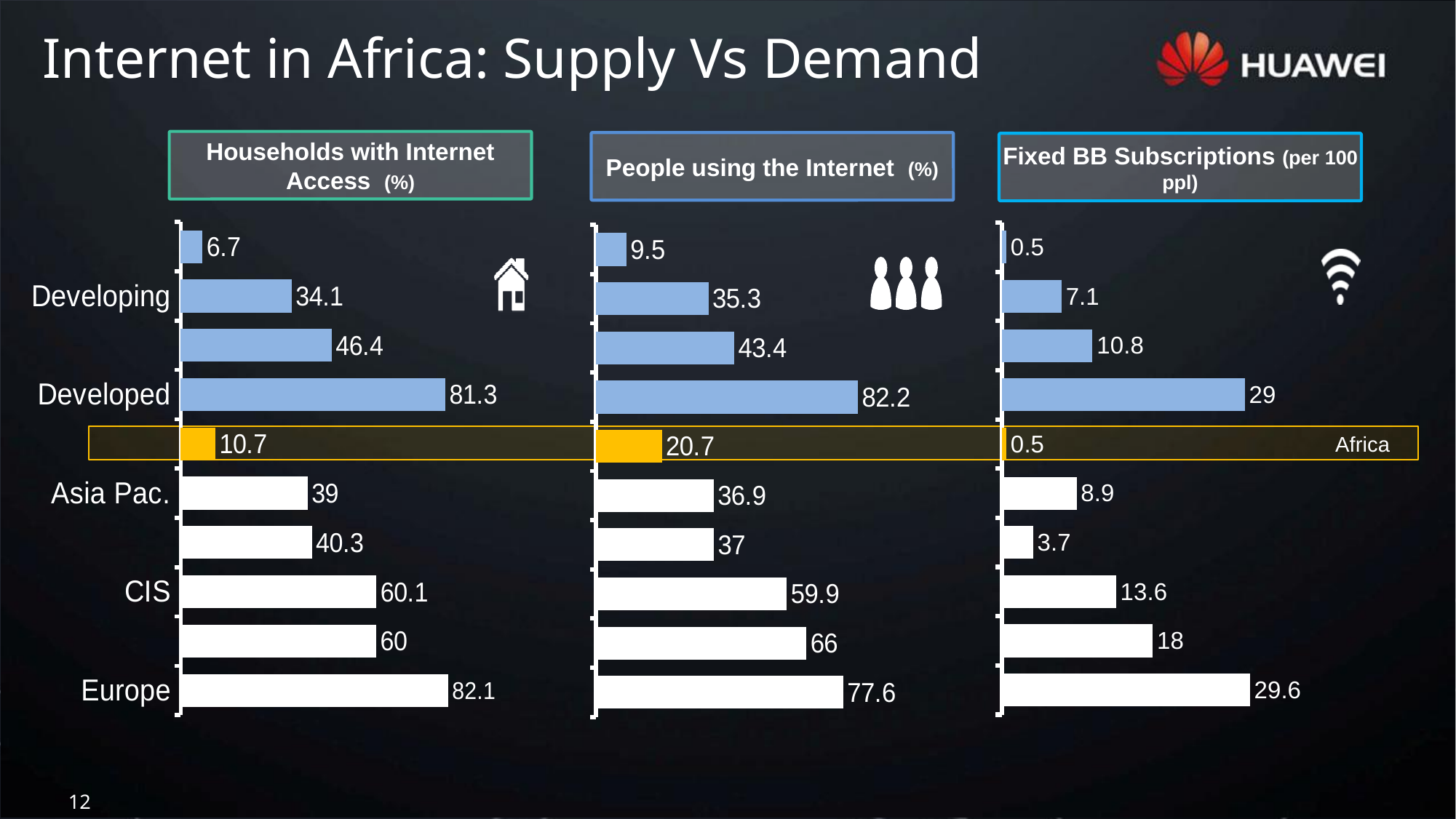
In the 'Fixed BB Subscriptions (per 100 ppl)' chart, what is the value for Asia Pac.? 8.9 In the 'Fixed BB Subscriptions (per 100 ppl)' chart, which category has the highest value? Europe In the 'People using the Internet (%)' chart, which is larger, Asia Pac. or CIS? CIS In the 'Households with Internet Access (%)' chart, what is the value for Africa? 10.7 What kind of chart is the 'Fixed BB Subscriptions (per 100 ppl)' chart? Bar chart In the 'Households with Internet Access (%)' chart, what is the difference between Europe and Africa? 71.4 In the 'People using the Internet (%)' chart, what is the difference between Developed and Developing? 46.9 How many bars are plotted in the 'Households with Internet Access (%)' chart? 10 In the 'People using the Internet (%)' chart, what colour is the Africa bar? Orange In the 'People using the Internet (%)' chart, what is the value for Developing? 35.3 In the 'Fixed BB Subscriptions (per 100 ppl)' chart, what is the value for CIS? 13.6 In the 'People using the Internet (%)' chart, which category has the highest value? Developed